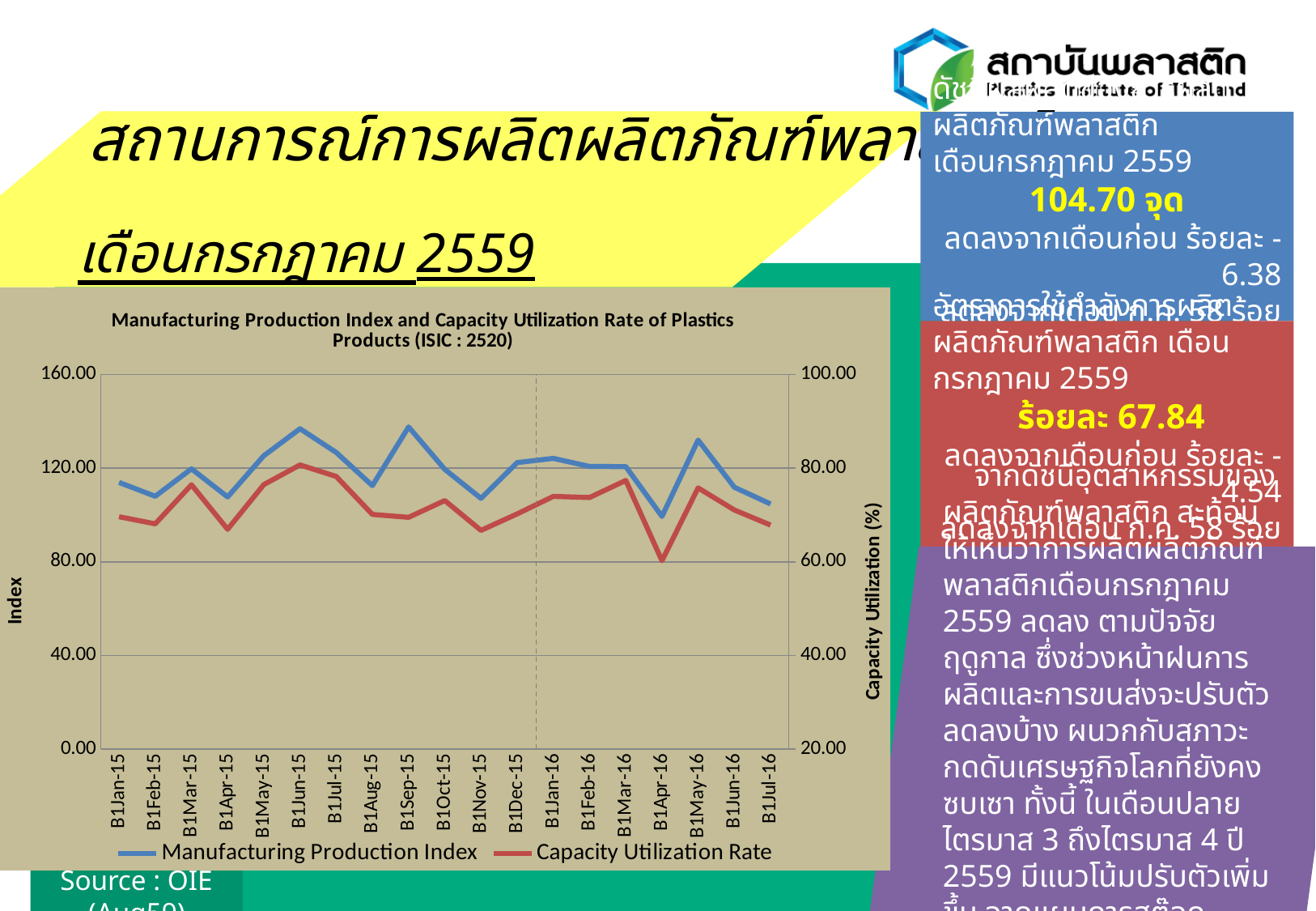
At which time point is the Manufacturing Production Index lowest? B1Apr-16 Which series is drawn in blue on the chart? Manufacturing Production Index Is the Capacity Utilization Rate for B1Apr-16 greater or less than 80.00? less Is the Manufacturing Production Index for B1Jun-15 greater or less than 120.00? greater How many series does the chart legend list? 2 What is the label of the right-hand vertical axis of the chart? Capacity Utilization (%) Is the Manufacturing Production Index for B1Apr-16 greater or less than 120.00? less Which is larger, the Manufacturing Production Index for B1Jun-15 or for B1Apr-16? B1Jun-15 How many time points are plotted along the x axis of the chart? 19 What kind of chart is shown on the slide? line chart At which time point is the Capacity Utilization Rate lowest? B1Apr-16